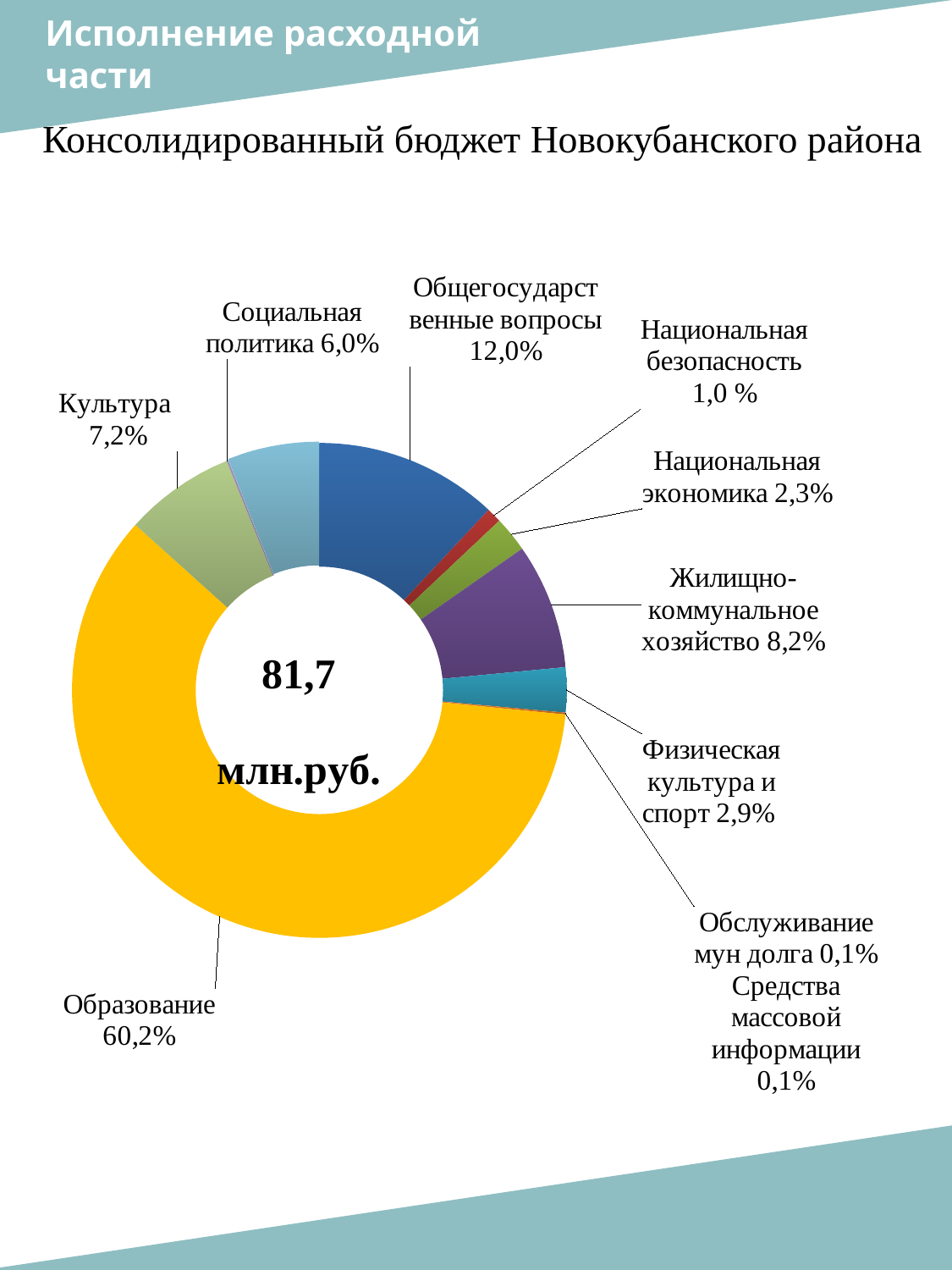
What is the difference in percentage points between Общегосударственные вопросы and Культура? 4,8 What percentage is shown for Жилищно-коммунальное хозяйство? 8,2% What share of the budget goes to Образование? 60,2% What share is labelled for Общегосударственные вопросы? 12,0% Which is larger, the share for Культура or the share for Социальная политика? Культура What kind of chart is shown on the slide? Doughnut (pie) chart Which is larger, the share for Национальная экономика or the share for Физическая культура и спорт? Физическая культура и спорт What is the combined share of Обслуживание мун долга and Средства массовой информации? 0,2% What total value is printed in the centre of the chart? 81,7 млн.руб. What percentage is shown for Физическая культура и спорт? 2,9% Which category has the largest share of the chart? Образование How many categories are shown in the chart? 10